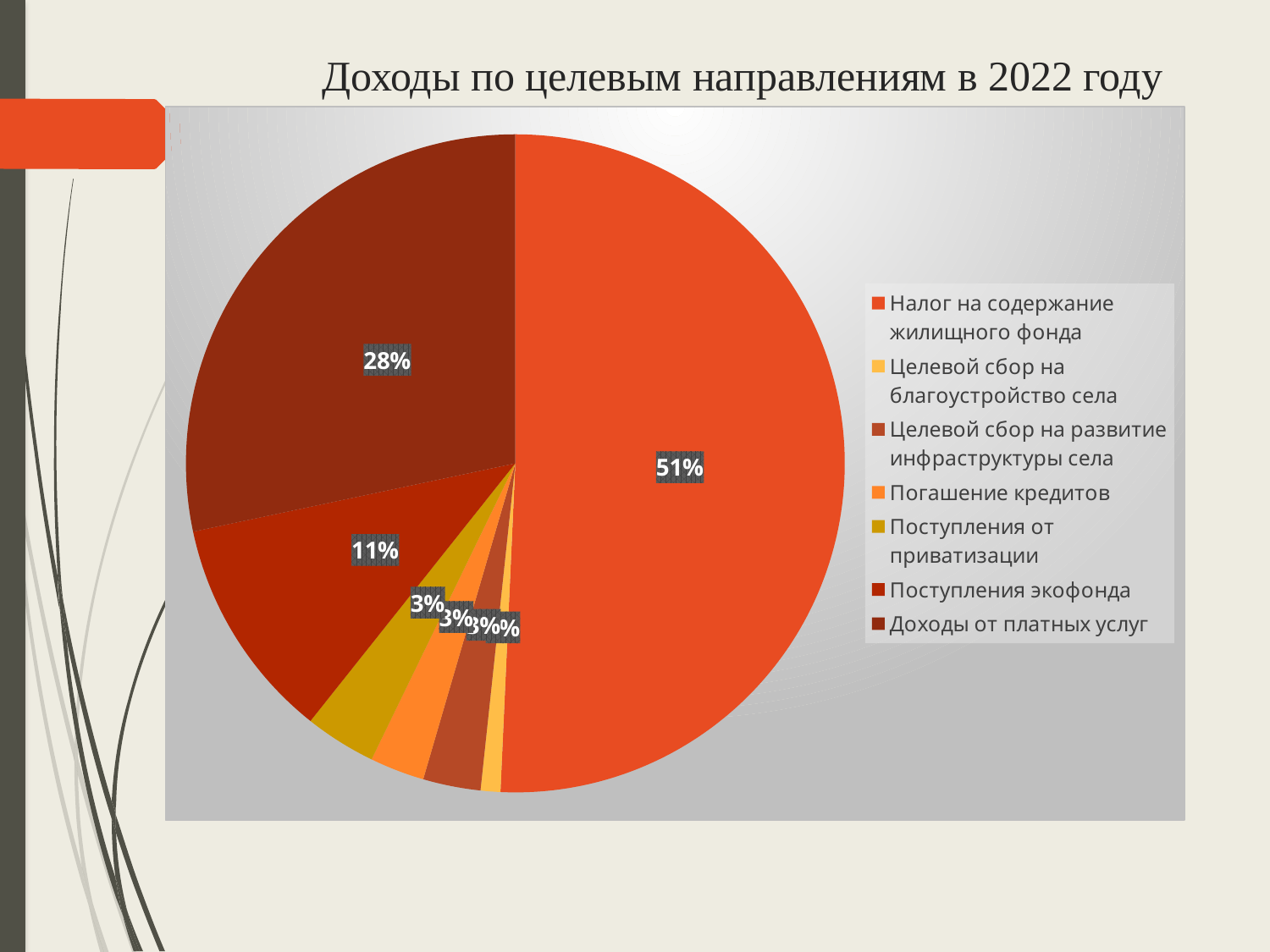
Which category has the smallest slice of the pie? Целевой сбор на благоустройство села Is the share for Налог на содержание жилищного фонда greater or less than 50%? greater What is the difference in percentage points between Налог на содержание жилищного фонда and Доходы от платных услуг? 23 What share of the pie is labelled for Налог на содержание жилищного фонда? 51% What share of the pie is labelled for Поступления от приватизации? 3% Which is larger: the slice for Доходы от платных услуг or the slice for Поступления экофонда? Доходы от платных услуг What share of the pie is labelled for Поступления экофонда? 11% How many categories does the legend list? 7 What share of the pie is labelled for Доходы от платных услуг? 28% What kind of chart is shown on the slide? pie chart Which category has the largest slice of the pie? Налог на содержание жилищного фонда What is the title of the chart? Доходы по целевым направлениям в 2022 году